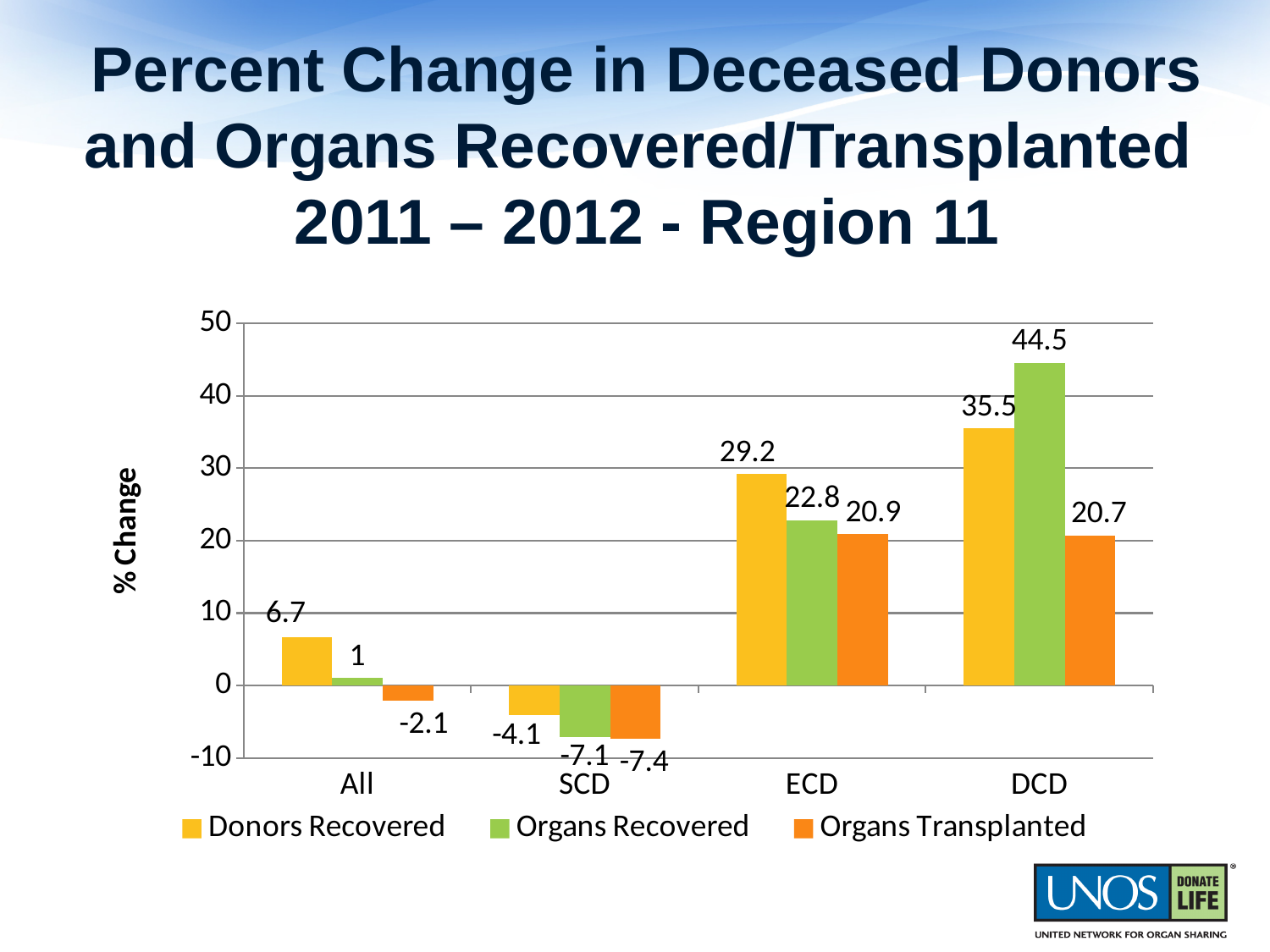
Which category has the highest Organs Transplanted value? ECD Which is larger for ECD: Donors Recovered or Organs Recovered? Donors Recovered What kind of chart is shown on the slide? Bar chart Which category has the lowest Donors Recovered value? SCD What is the Organs Recovered value for DCD? 44.5 How many categories are shown on the x axis? 4 What is the Organs Recovered value for All? 1 How many series does the legend list? 3 What is the label of the y axis? % Change What is the Donors Recovered value for ECD? 29.2 What is the Organs Transplanted value for SCD? -7.4 What is the difference between the Donors Recovered and Organs Recovered values for DCD? 9